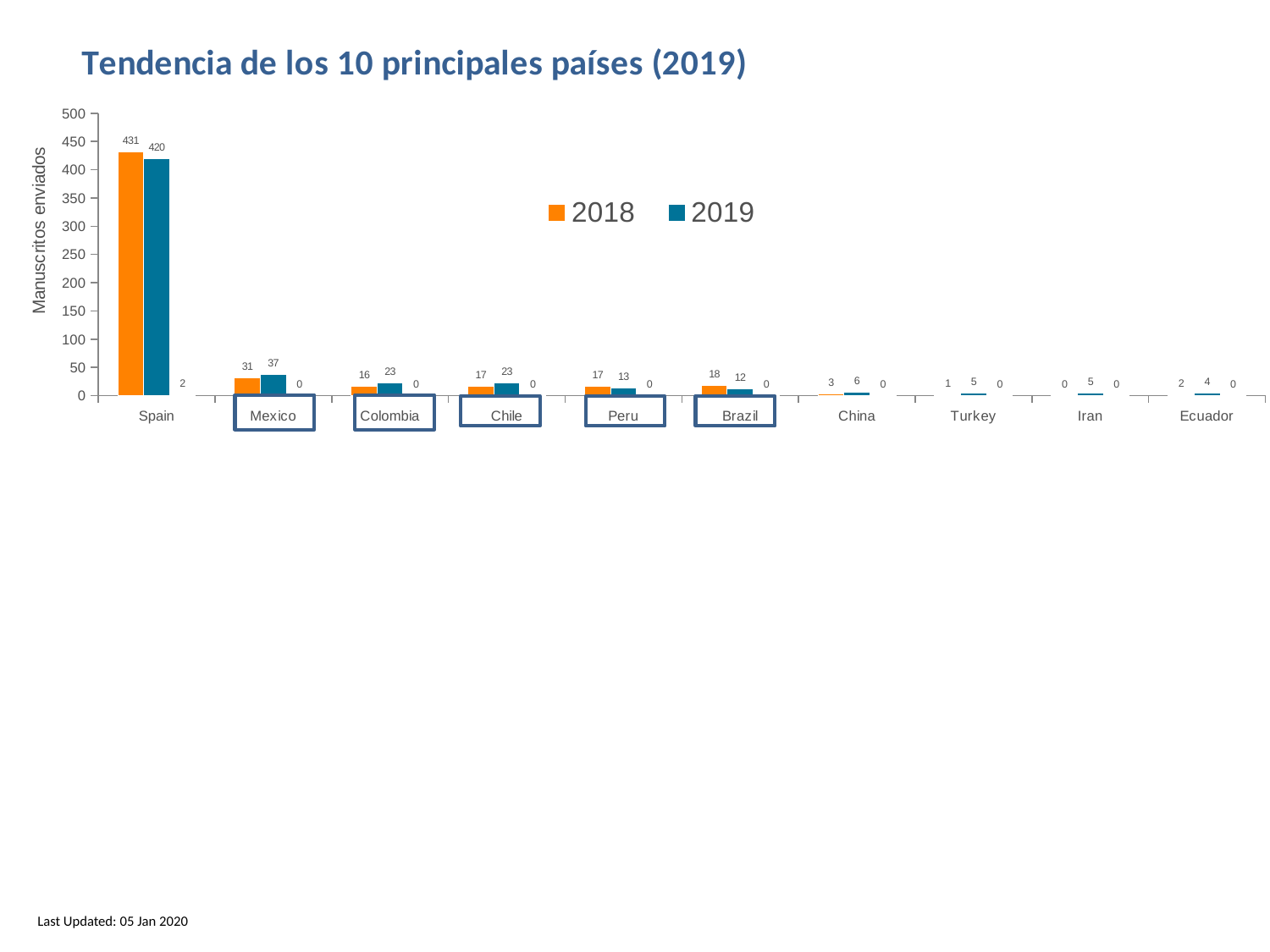
How many series does the legend list? 2 Which country has the highest value in 2019? Spain How many countries are shown on the x axis? 10 Which is larger for Colombia: the 2018 value or the 2019 value? 2019 What was the value for Spain in 2019? 420 What is the difference between the 2018 and 2019 values for Spain? 11 What kind of chart is shown on the slide? Bar chart What was the value for Mexico in 2019? 37 What was the value for Spain in 2018? 431 Which is larger for Peru: the 2018 value or the 2019 value? 2018 What is the label of the y axis? Manuscritos enviados What was the value for Brazil in 2018? 18